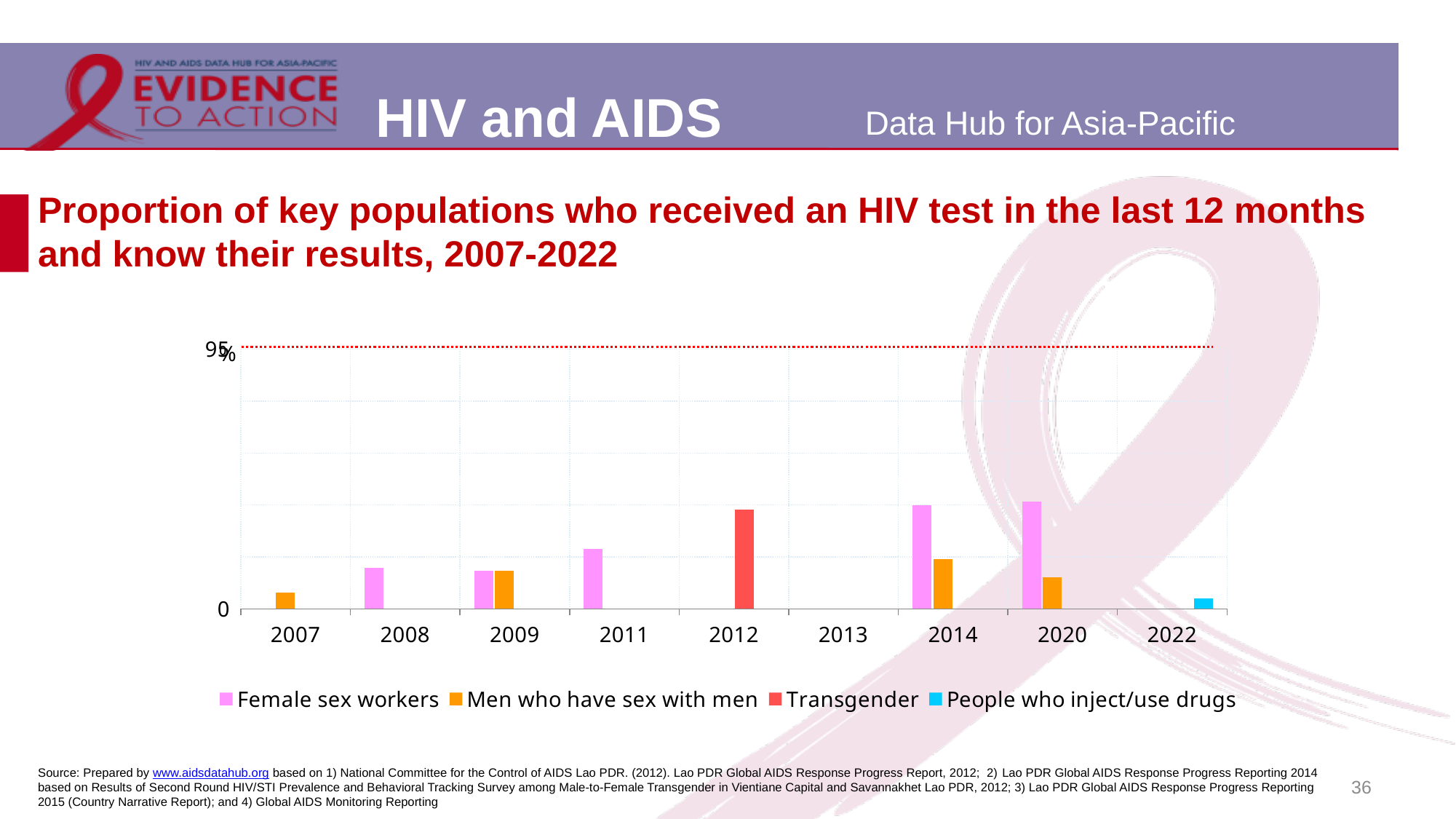
What kind of chart is shown on the slide? bar chart Do the values for Female sex workers generally rise or fall from 2008 to 2020? rise How many years are shown on the x axis? 9 In which year is the only value for People who inject/use drugs shown? 2022 In which year is the value for Men who have sex with men highest? 2014 Is the value for Female sex workers in 2020 greater or less than 95? less Which is larger: the Transgender value in 2012 or the Female sex workers value in 2011? Transgender in 2012 In which year is the only value for Transgender shown? 2012 How many series does the legend list? 4 In which year is the value for Men who have sex with men lowest? 2007 In 2014, which is larger: the value for Female sex workers or for Men who have sex with men? Female sex workers What value does the dotted red horizontal line mark on the y axis? 95%